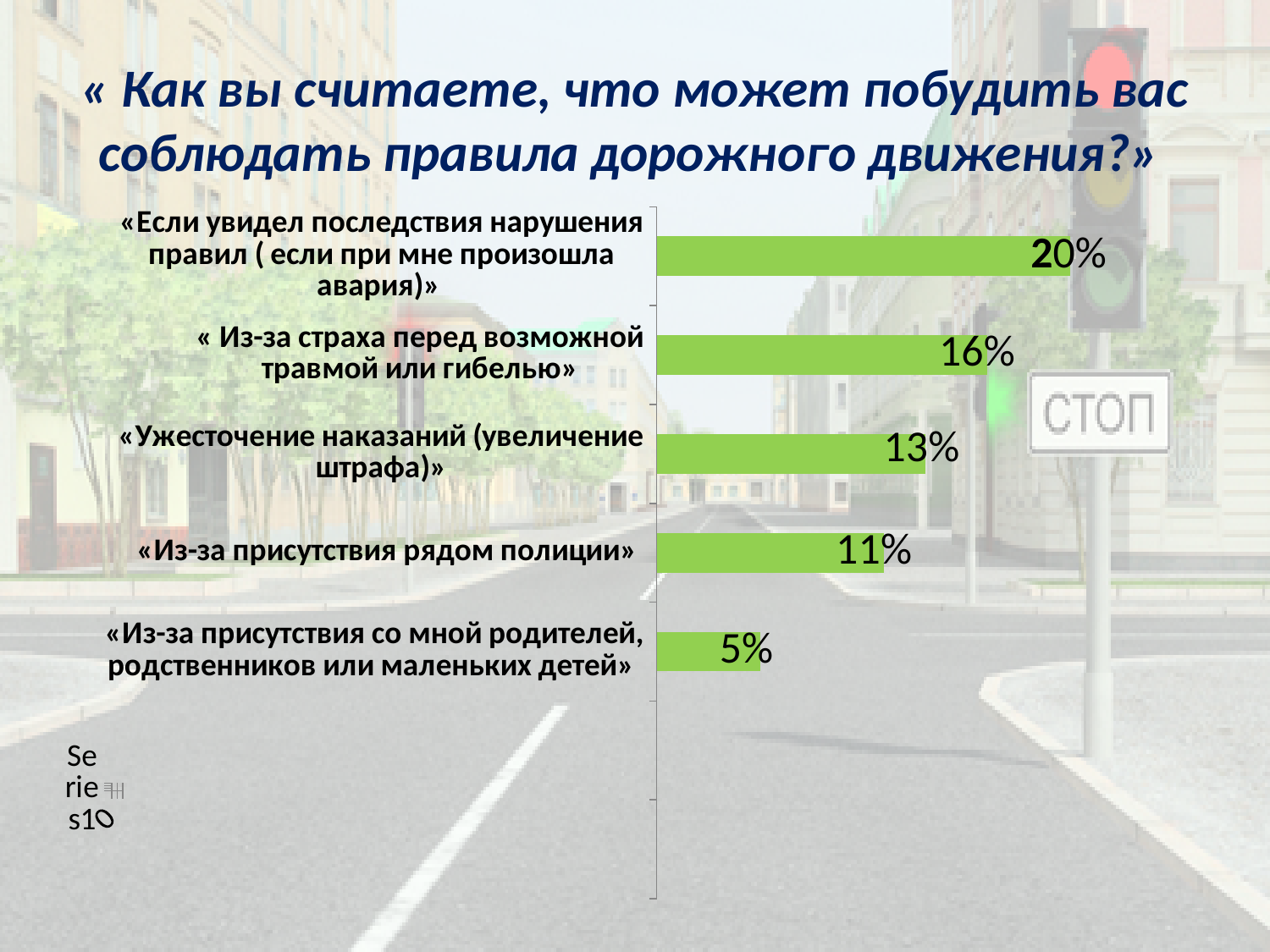
Which category has the highest value? «Если увидел последствия нарушения правил ( если при мне произошла авария)» What is the value for «Из-за присутствия рядом полиции»? 11% What kind of chart is shown on the slide? Bar chart Which is larger: the value for «Ужесточение наказаний (увеличение штрафа)» or the value for «Из-за присутствия рядом полиции»? «Ужесточение наказаний (увеличение штрафа)» What is the value for «Если увидел последствия нарушения правил ( если при мне произошла авария)»? 20% What colour are the bars in the chart? Green What is the difference between the values for «Если увидел последствия нарушения правил ( если при мне произошла авария)» and «Из-за присутствия рядом полиции»? 9% What is the value for «Из-за присутствия со мной родителей, родственников или маленьких детей»? 5% What is the difference between the values for « Из-за страха перед возможной травмой или гибелью» and «Ужесточение наказаний (увеличение штрафа)»? 3% What is the value for « Из-за страха перед возможной травмой или гибелью»? 16% Which category has the lowest value? «Из-за присутствия со мной родителей, родственников или маленьких детей» What is the value for «Ужесточение наказаний (увеличение штрафа)»? 13%